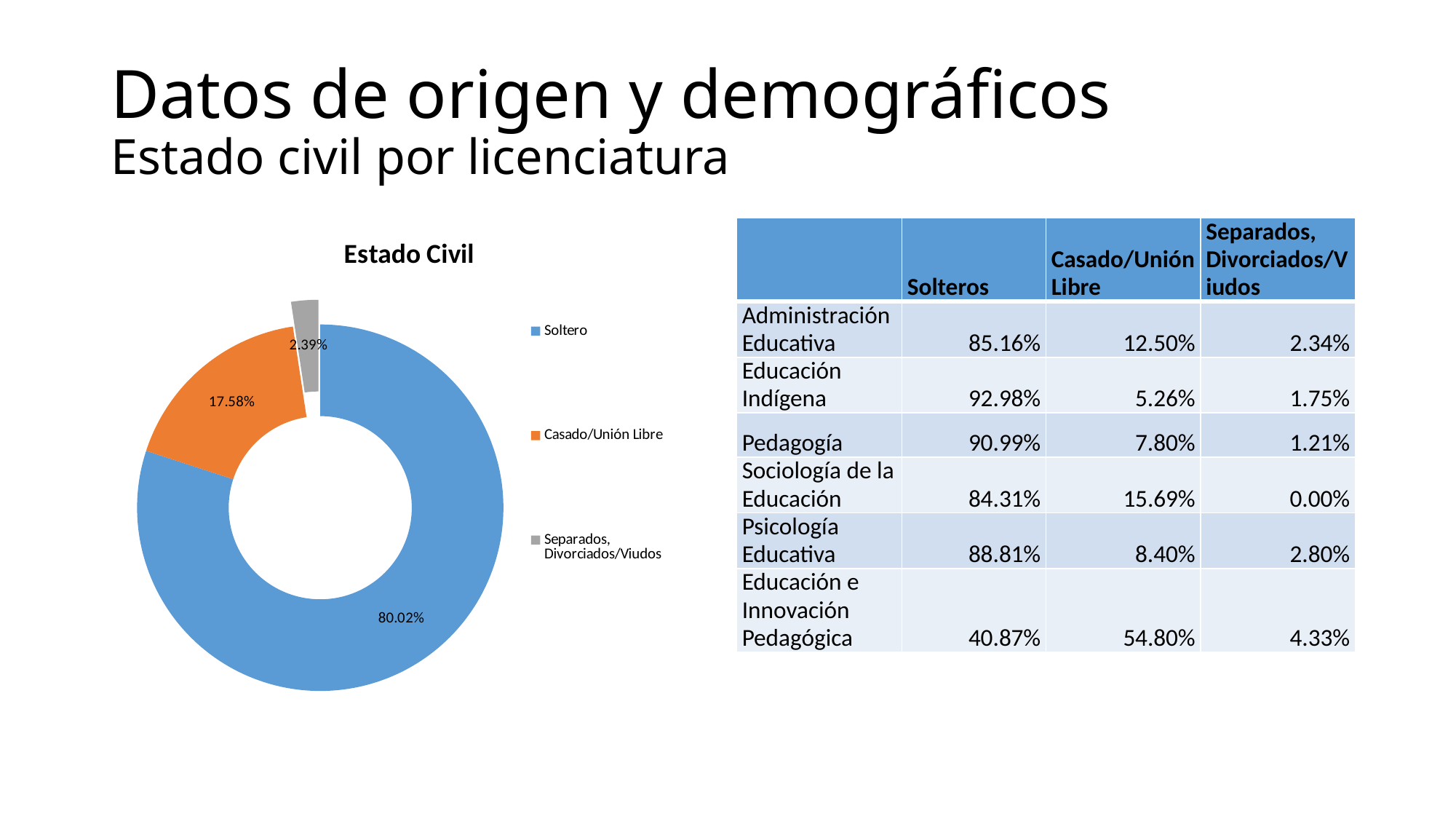
How many categories does the Estado Civil chart show? 3 Which is larger in the Estado Civil chart, Casado/Unión Libre or Separados, Divorciados/Viudos? Casado/Unión Libre Which category has the smallest share in the Estado Civil chart? Separados, Divorciados/Viudos What is the value for Casado/Unión Libre in the Estado Civil chart? 17.58% What is the title of the chart? Estado Civil Which category has the largest share in the Estado Civil chart? Soltero What kind of chart is shown on the slide? doughnut chart What colour is the Casado/Unión Libre slice in the Estado Civil chart? orange What is the value for Soltero in the Estado Civil chart? 80.02% What is the difference between the Casado/Unión Libre and Separados, Divorciados/Viudos values in the Estado Civil chart? 15.19% What is the value for Separados, Divorciados/Viudos in the Estado Civil chart? 2.39% What is the difference between the Soltero and Casado/Unión Libre values in the Estado Civil chart? 62.44%